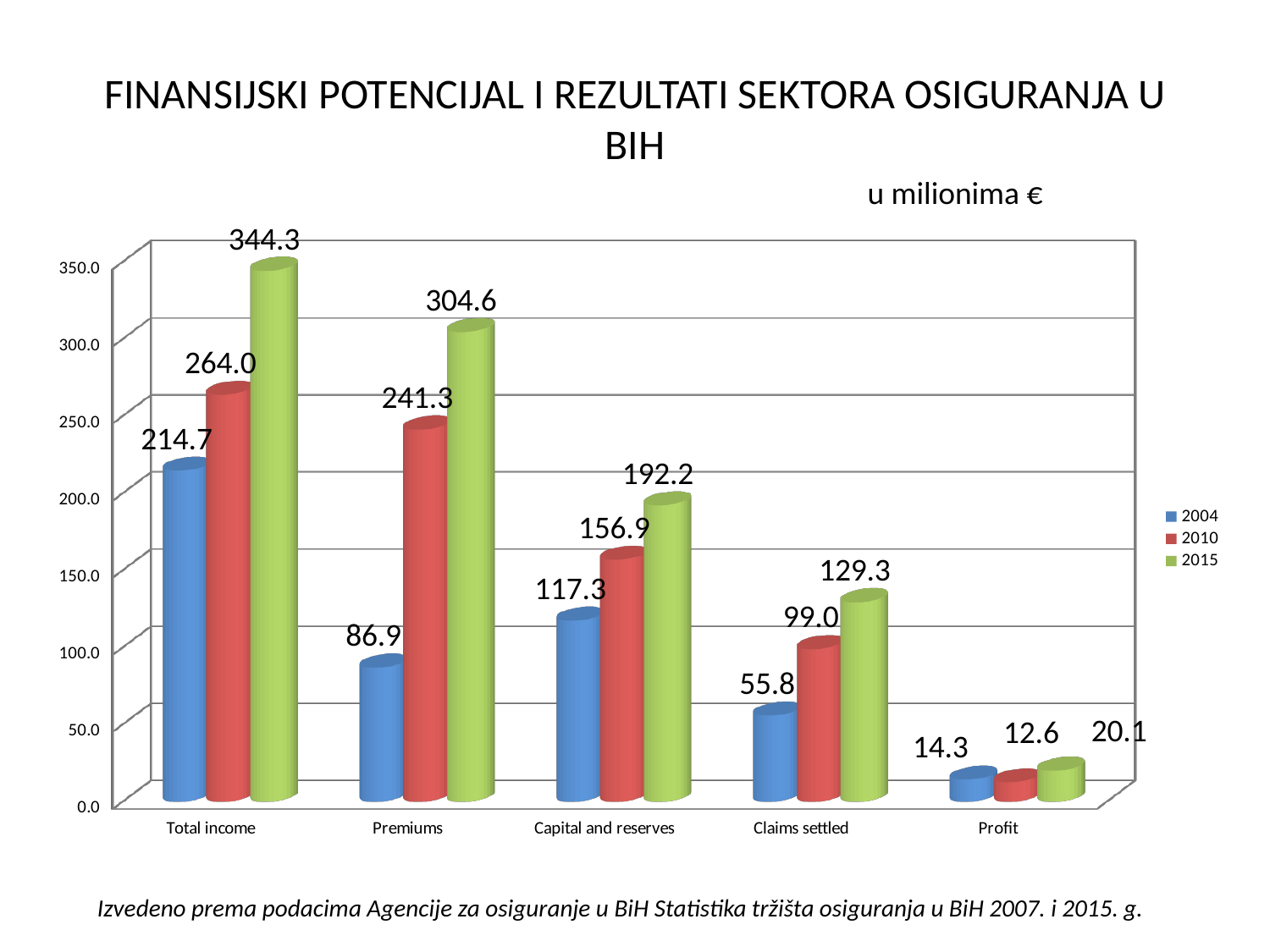
What unit is stated above the chart? u milionima € Which is larger for Profit: the 2004 value or the 2010 value? 2004 What is the value for Total income in 2015? 344.3 What is the value for Profit in 2015? 20.1 What is the value for Premiums in 2004? 86.9 How many series does the legend list? 3 Which category has the lowest value in 2004? Profit What is the value for Claims settled in 2010? 99.0 What is the difference between the 2015 and 2004 values for Premiums? 217.7 How many categories are shown on the x axis? 5 Which category has the highest value in 2015? Total income What kind of chart is shown on the slide? Bar chart